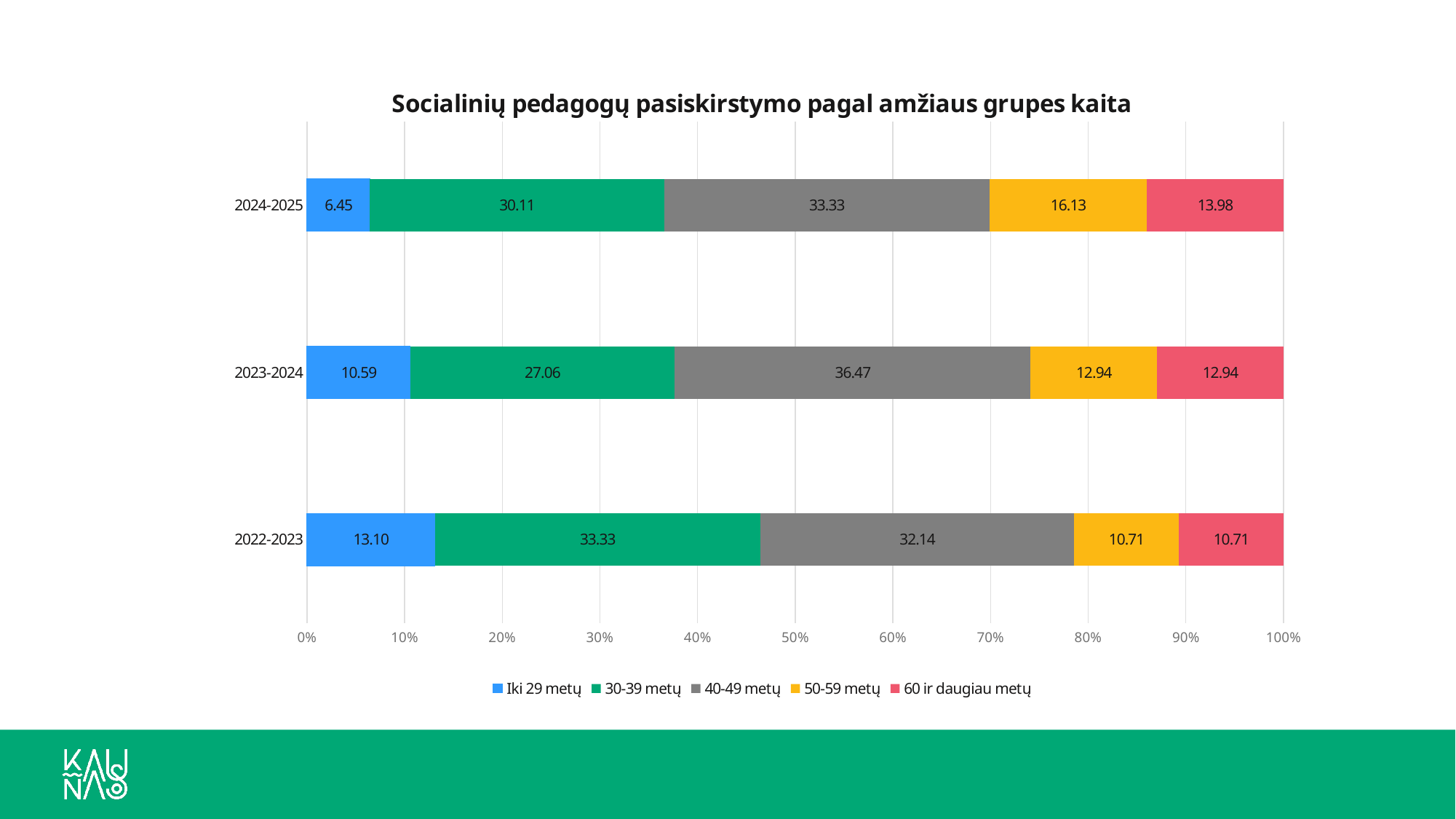
Which age group has the smallest segment in the 2024-2025 bar? Iki 29 metų Which is larger for Iki 29 metų: the 2022-2023 value or the 2024-2025 value? 2022-2023 What is the title of the chart? Socialinių pedagogų pasiskirstymo pagal amžiaus grupes kaita What is the difference between the 40-49 metų and 30-39 metų values in 2023-2024? 9.41 What is the value for 40-49 metų in 2023-2024? 36.47 How does the Iki 29 metų value change from 2022-2023 to 2024-2025? It falls Which age group has the largest segment in the 2024-2025 bar? 40-49 metų What is the value for 30-39 metų in 2022-2023? 33.33 How many school years (categories) are shown on the chart? 3 What kind of chart is shown on the slide? Stacked bar chart How many age groups does the legend list? 5 What is the value for Iki 29 metų in 2024-2025? 6.45